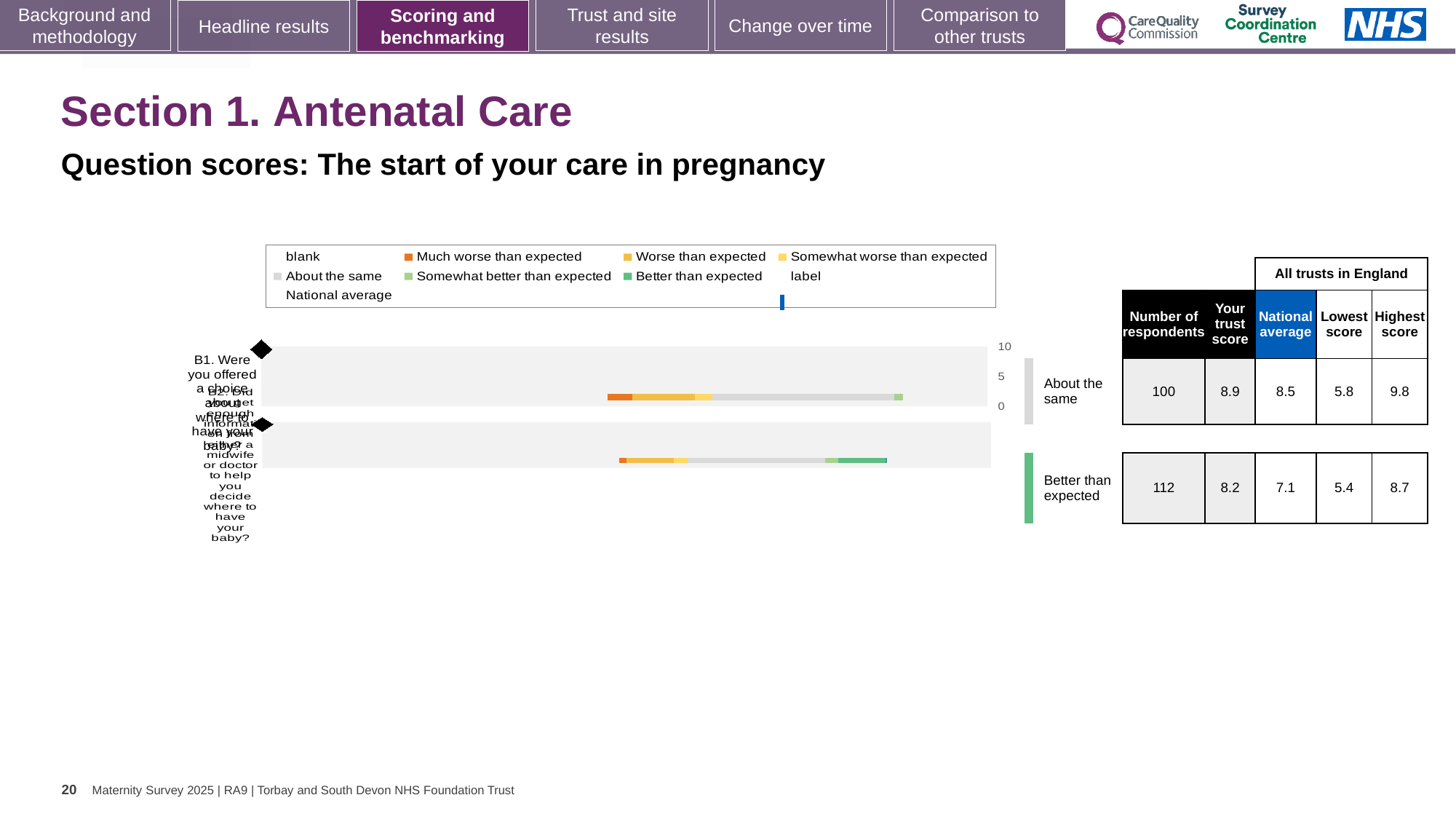
Which question row has more respondents, B1 (first row) or B2 (second row)? B2 By how much does the trust score for B2 (second row) exceed its national average? 1.1 Which question row has the higher trust score, B1 (first row) or B2 (second row)? B1 In the chart legend, what colour represents 'Much worse than expected'? orange What is the highest score across all trusts in England for question B1 (the first row)? 9.8 What is the lowest score across all trusts in England for question B2 (the second row)? 5.4 What is the trust score for question B1 (the first row, rated 'About the same')? 8.9 How many question rows (categories) are plotted in the chart? 2 What is the national average for question B2 (the second row, rated 'Better than expected')? 7.1 In the chart legend, what colour represents 'Better than expected'? green What kind of chart is shown on the slide? bar chart How many respondents answered question B2 (the second row)? 112